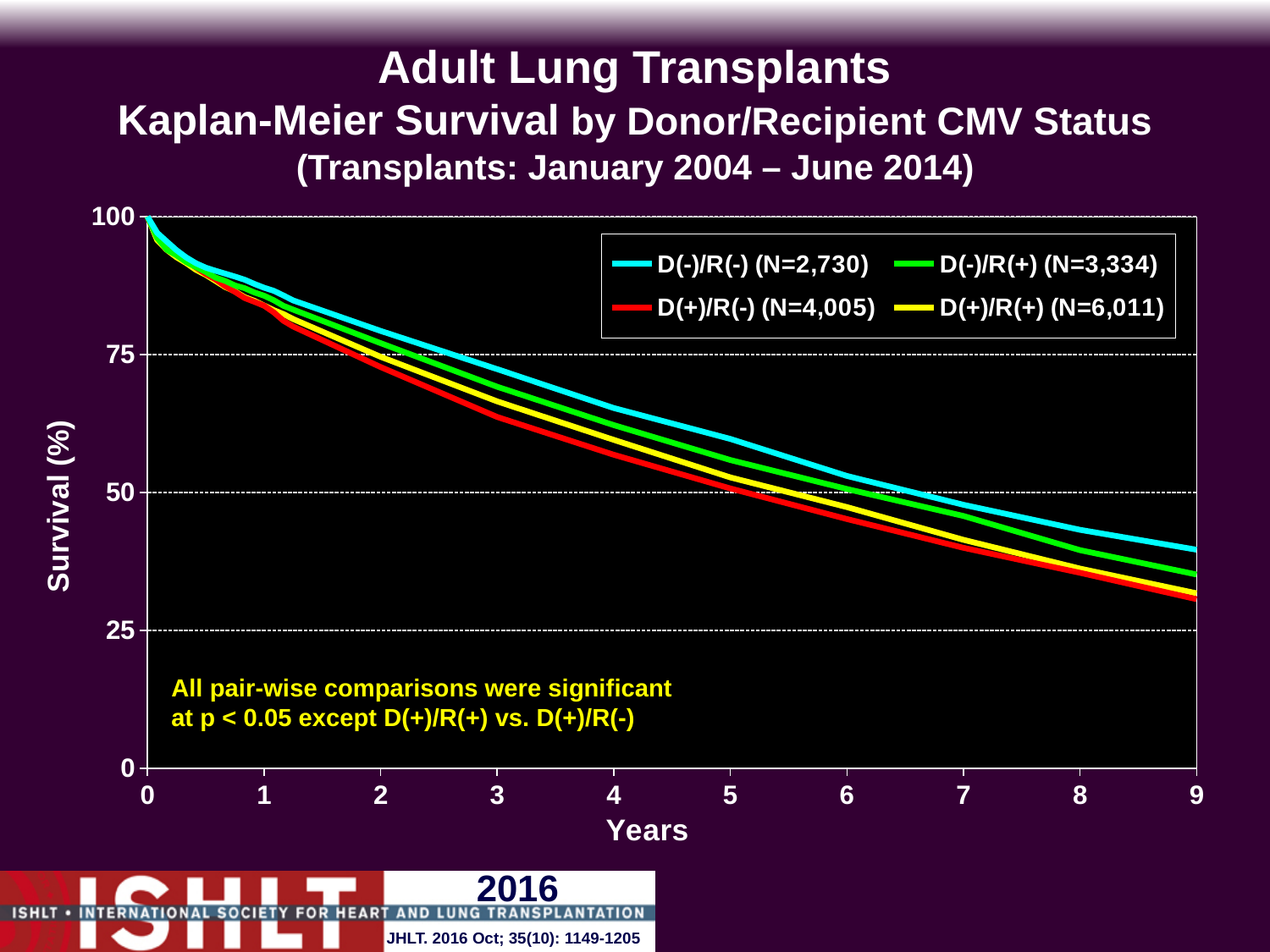
Is the survival for D(-)/R(-) at 5 years greater or less than 50? greater Do the survival curves rise or fall as years increase? fall Which CMV status group has the lowest survival curve across the follow-up period? D(+)/R(-) How many series does the legend list? 4 Which pair-wise comparison was not significant at p < 0.05 according to the note on the chart? D(+)/R(+) vs. D(+)/R(-) What is the N for the D(+)/R(+) group shown in the legend? 6,011 Which CMV status group has the highest survival curve at 9 years? D(-)/R(-) What kind of chart is shown on the slide? line chart Is the survival for D(+)/R(-) at 6 years greater or less than 50? less What is the N for the D(+)/R(-) group shown in the legend? 4,005 What is the N for the D(-)/R(-) group shown in the legend? 2,730 Is the survival for D(-)/R(-) at 1 year greater or less than 75? greater